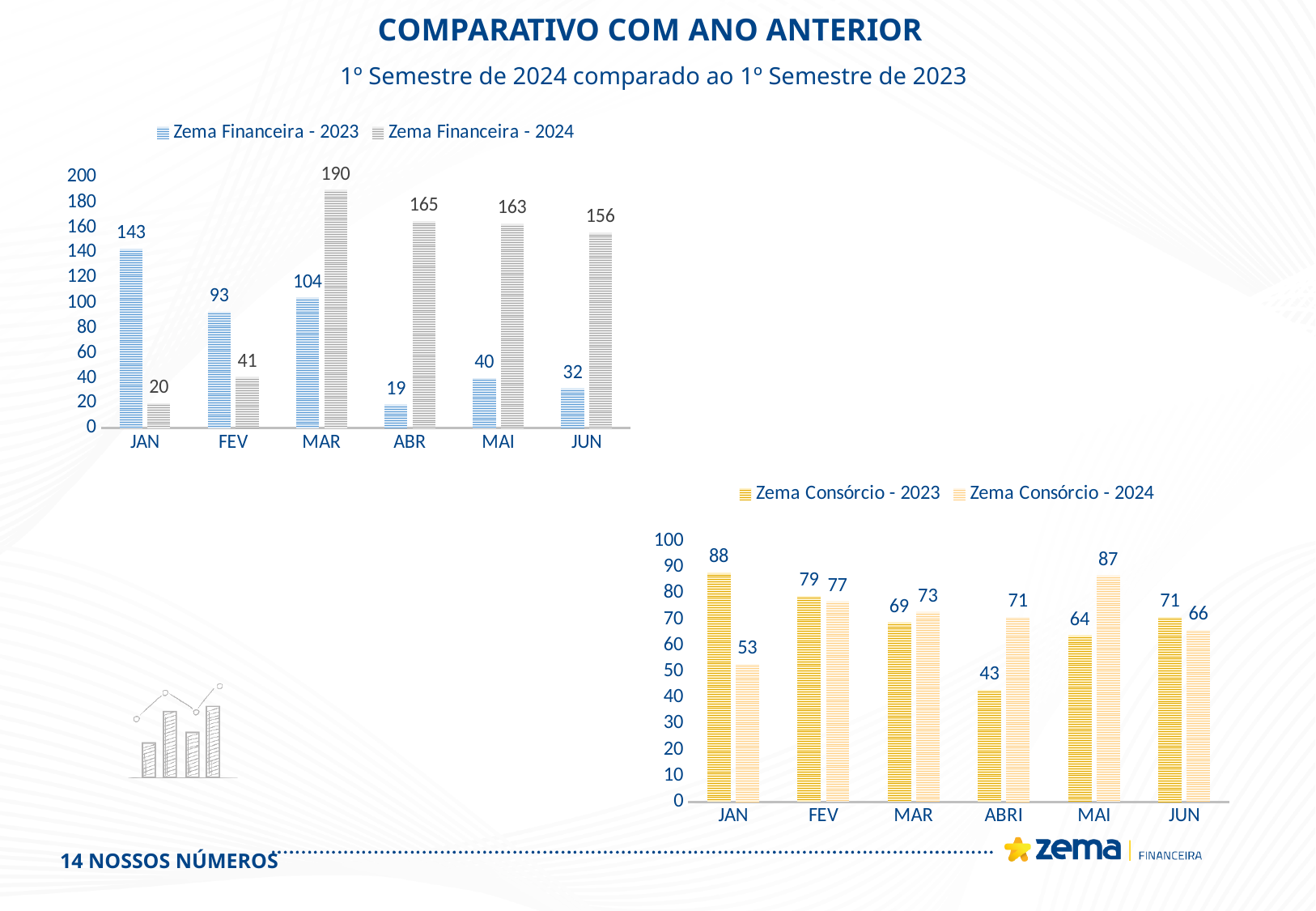
In the Zema Financeira chart (top left), what is the value for Zema Financeira - 2023 in JAN? 143 In the Zema Financeira chart (top left), what is the value for Zema Financeira - 2024 in MAR? 190 In the Zema Consórcio chart (bottom right), is the value for Zema Consórcio - 2023 in ABRI greater or less than 50? less In the Zema Financeira chart (top left), what is the difference between the 2024 and 2023 values in ABR? 146 What kind of chart is the Zema Consórcio chart (bottom right)? Bar chart In the Zema Consórcio chart (bottom right), what is the difference between the 2023 and 2024 values in JAN? 35 In the Zema Financeira chart (top left), which is larger in FEV: Zema Financeira - 2023 or Zema Financeira - 2024? Zema Financeira - 2023 In the Zema Consórcio chart (bottom right), what is the value for Zema Consórcio - 2024 in MAI? 87 In the Zema Consórcio chart (bottom right), which month has the highest value for Zema Consórcio - 2023? JAN In the Zema Consórcio chart (bottom right), how many months are shown on the x axis? 6 In the Zema Financeira chart (top left), which month has the lowest value for Zema Financeira - 2023? ABR In the Zema Financeira chart (top left), how many series does the legend list? 2